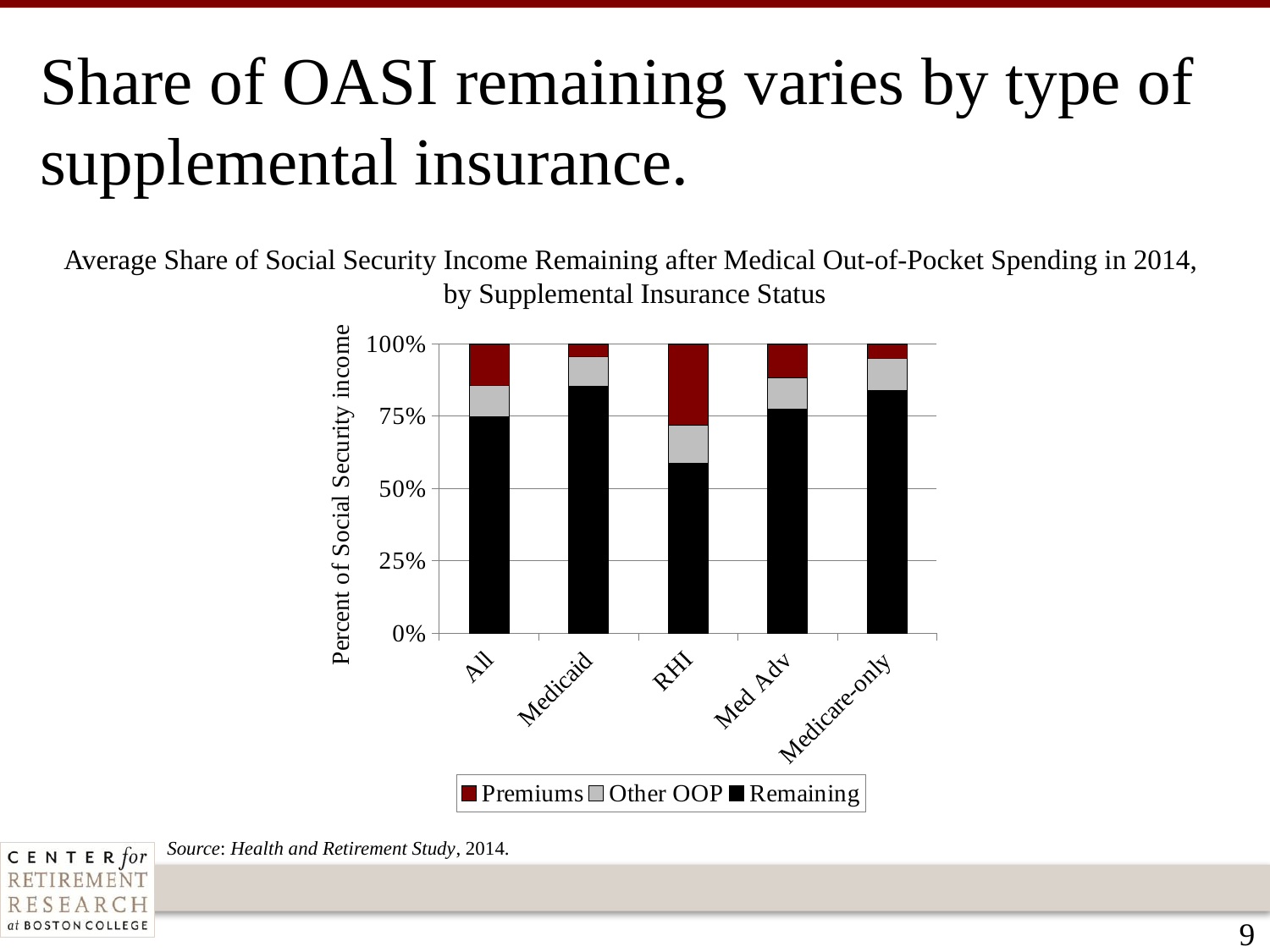
How many supplemental insurance categories are shown on the x axis? 5 What type of chart is shown on the slide? Stacked bar chart Is the Remaining value for RHI greater or less than 75%? less How many series does the legend list? 3 What does each stacked bar total on the y axis? 100% Which category has the largest Premiums share? RHI Which category has the lowest Remaining share? RHI Is the Remaining value for RHI greater or less than 50%? greater What is the label on the y axis? Percent of Social Security income Which has a larger Premiums share, Medicaid or RHI? RHI Which series is shown in black? Remaining Is the Remaining value for Medicaid greater or less than 75%? greater